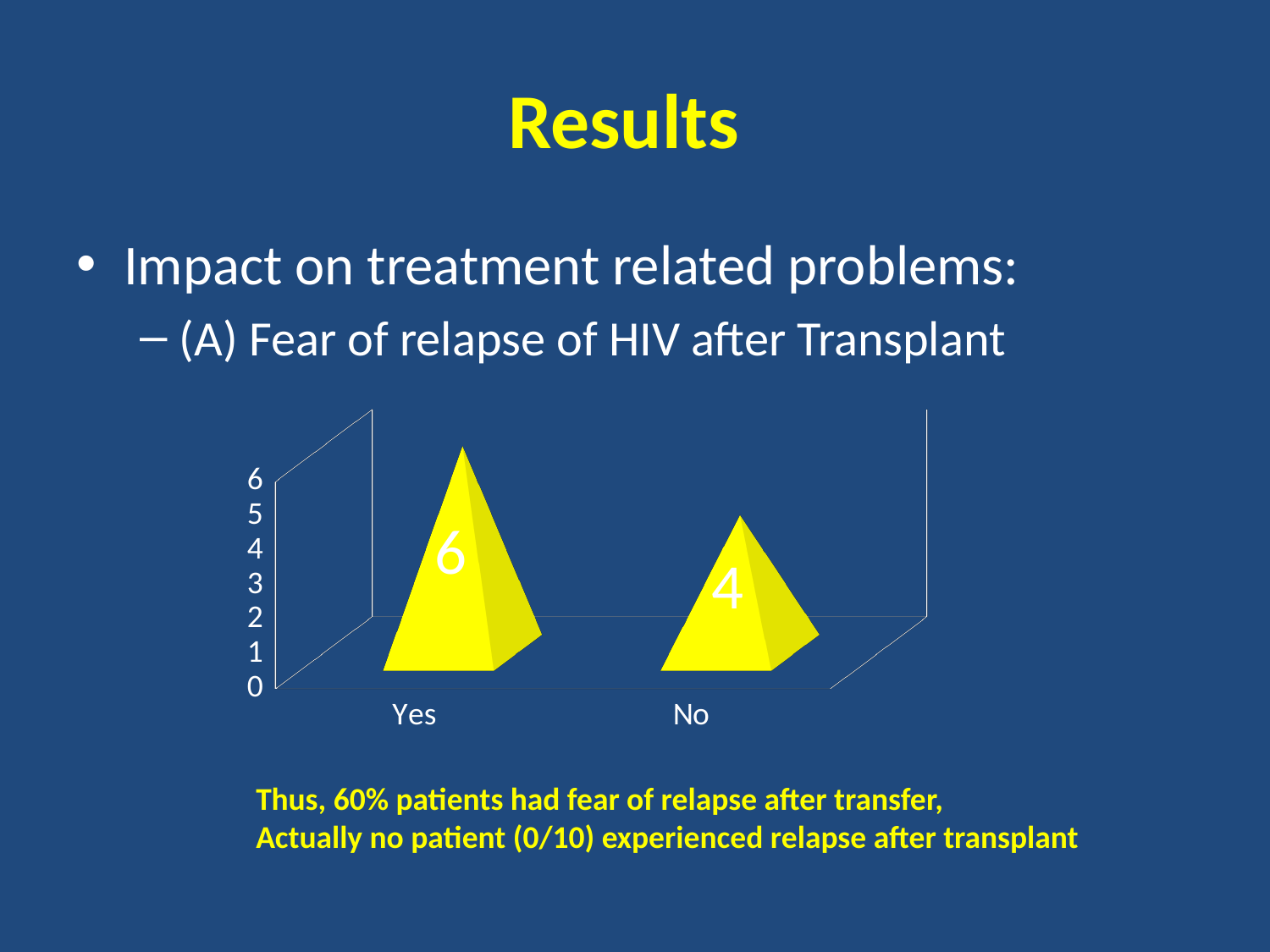
What colour are the bars in the chart? yellow What is the value for Yes? 6 How many categories are shown on the x axis? 2 Which category has the highest value? Yes Which is larger, the value for Yes or the value for No? Yes What is the total of the values for Yes and No? 10 Which category has the lowest value? No What is the highest value shown on the vertical axis? 6 What is the difference between the values for Yes and No? 2 What is the value for No? 4 What kind of chart is shown on the slide? bar chart Is the value for No greater or less than 5? less